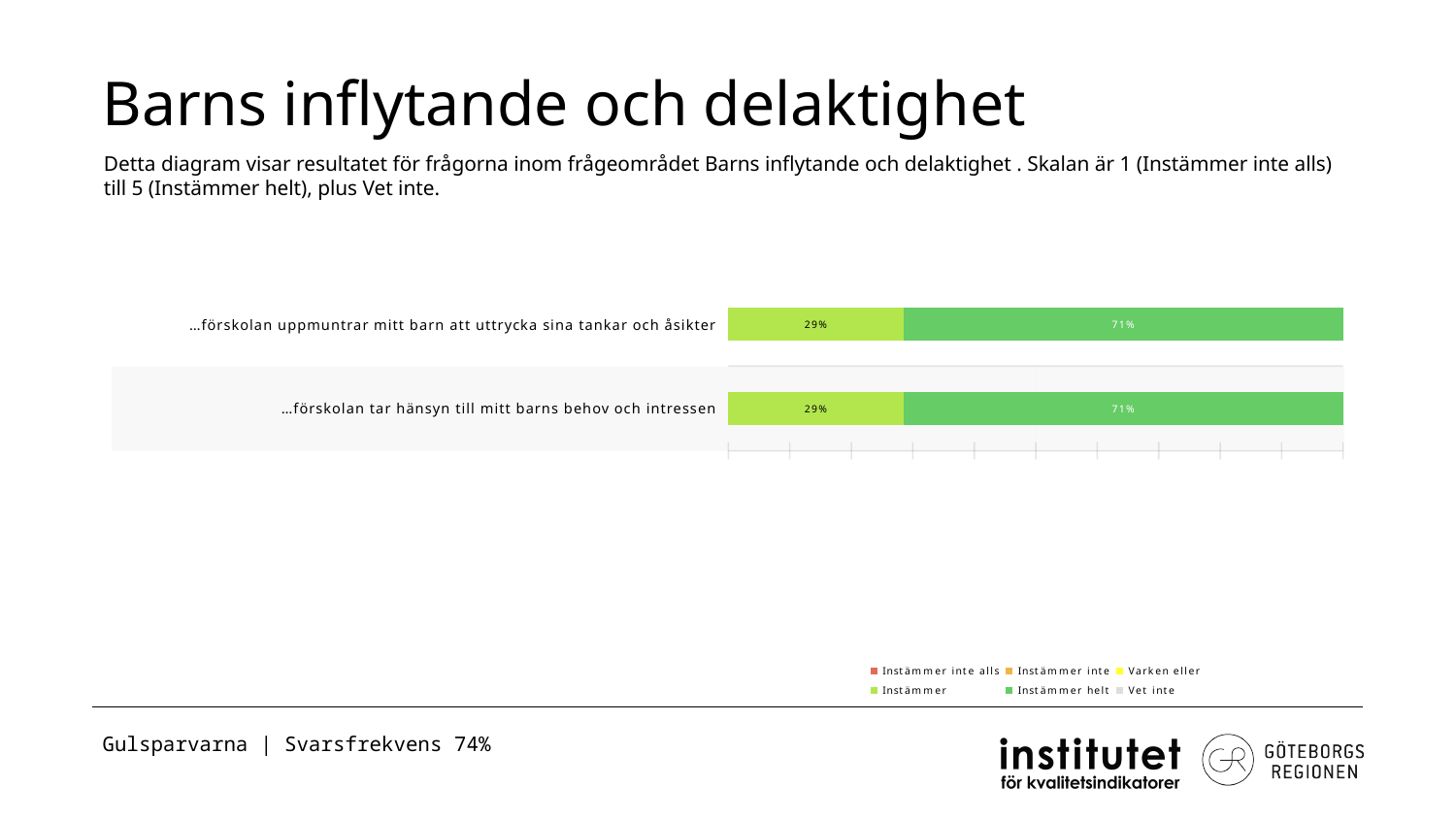
How many categories (questions) are plotted in the chart? 2 Which legend entry is shown in red? Instämmer inte alls For "…förskolan uppmuntrar mitt barn att uttrycka sina tankar och åsikter", which is larger: "Instämmer" or "Instämmer helt"? Instämmer helt What is the value of "Instämmer helt" for "…förskolan tar hänsyn till mitt barns behov och intressen"? 71% How many series does the legend list? 6 What is the value of "Instämmer" for "…förskolan uppmuntrar mitt barn att uttrycka sina tankar och åsikter"? 29% What is the title of the slide containing the chart? Barns inflytande och delaktighet What is the value of "Instämmer helt" for "…förskolan uppmuntrar mitt barn att uttrycka sina tankar och åsikter"? 71% What is the difference between "Instämmer helt" and "Instämmer" for "…förskolan tar hänsyn till mitt barns behov och intressen"? 42% What kind of chart is shown on the slide? Stacked bar chart What is the total of the labelled segments in the bar for "…förskolan uppmuntrar mitt barn att uttrycka sina tankar och åsikter"? 100% What is the value of "Instämmer" for "…förskolan tar hänsyn till mitt barns behov och intressen"? 29%